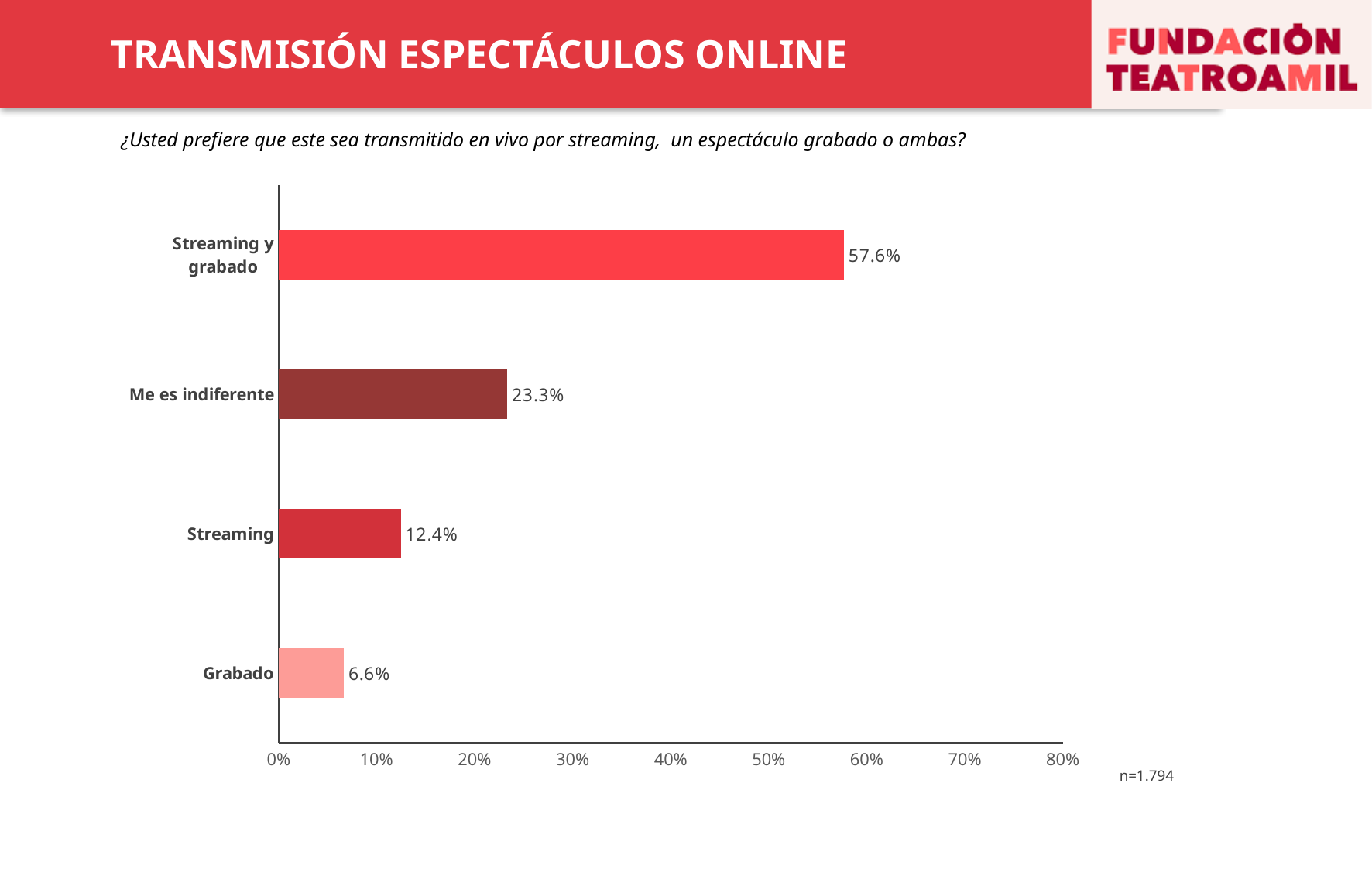
What is the difference between 'Streaming y grabado' and 'Me es indiferente'? 34.3% What kind of chart is shown on the slide? Bar chart How many categories are shown in the chart? 4 What percentage chose 'Streaming'? 12.4% Which is larger, the value for 'Streaming' or the value for 'Grabado'? Streaming What is the difference between 'Streaming' and 'Grabado'? 5.8% What percentage of respondents prefer 'Streaming y grabado'? 57.6% Which category has the lowest value? Grabado What is the value for 'Me es indiferente'? 23.3% Which category has the highest value? Streaming y grabado What is the value shown for 'Grabado'? 6.6% What is the sample size (n) noted below the chart? n=1.794